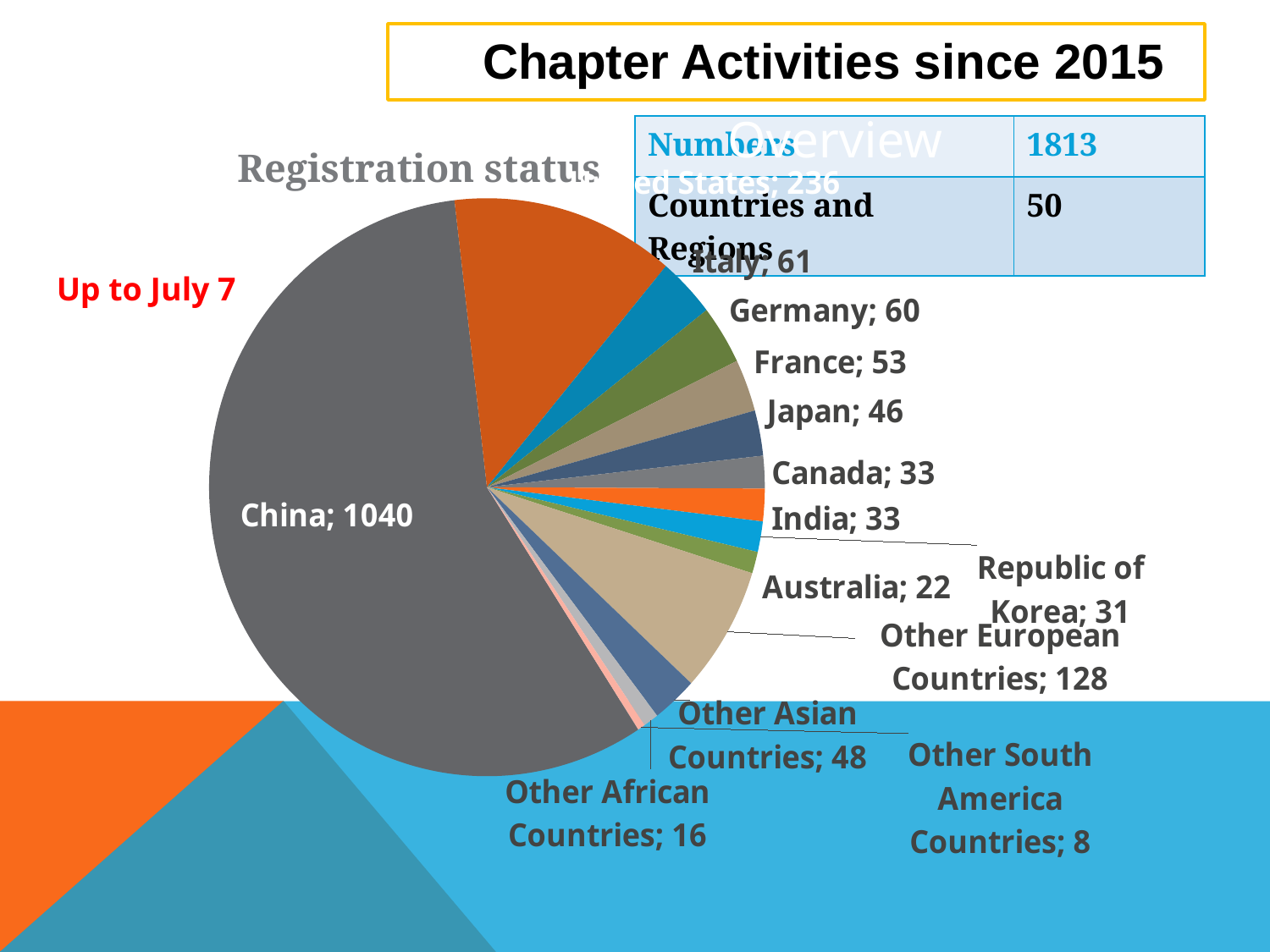
What is the value for Germany in the pie chart? 60 What is the value for China in the pie chart? 1040 What is the value for Japan in the pie chart? 46 Which category has the smallest slice of the pie chart? Other South America Countries What is the value for Other European Countries in the pie chart? 128 Which is larger, the value for Republic of Korea or the value for Australia? Republic of Korea What is the title of the chart? Registration status What is the difference between the values for Italy and Germany? 1 What is the difference between the values for France and Japan? 7 What is the value for Other African Countries in the pie chart? 16 What kind of chart is shown on the slide? pie chart Which category has the largest slice of the pie chart? China